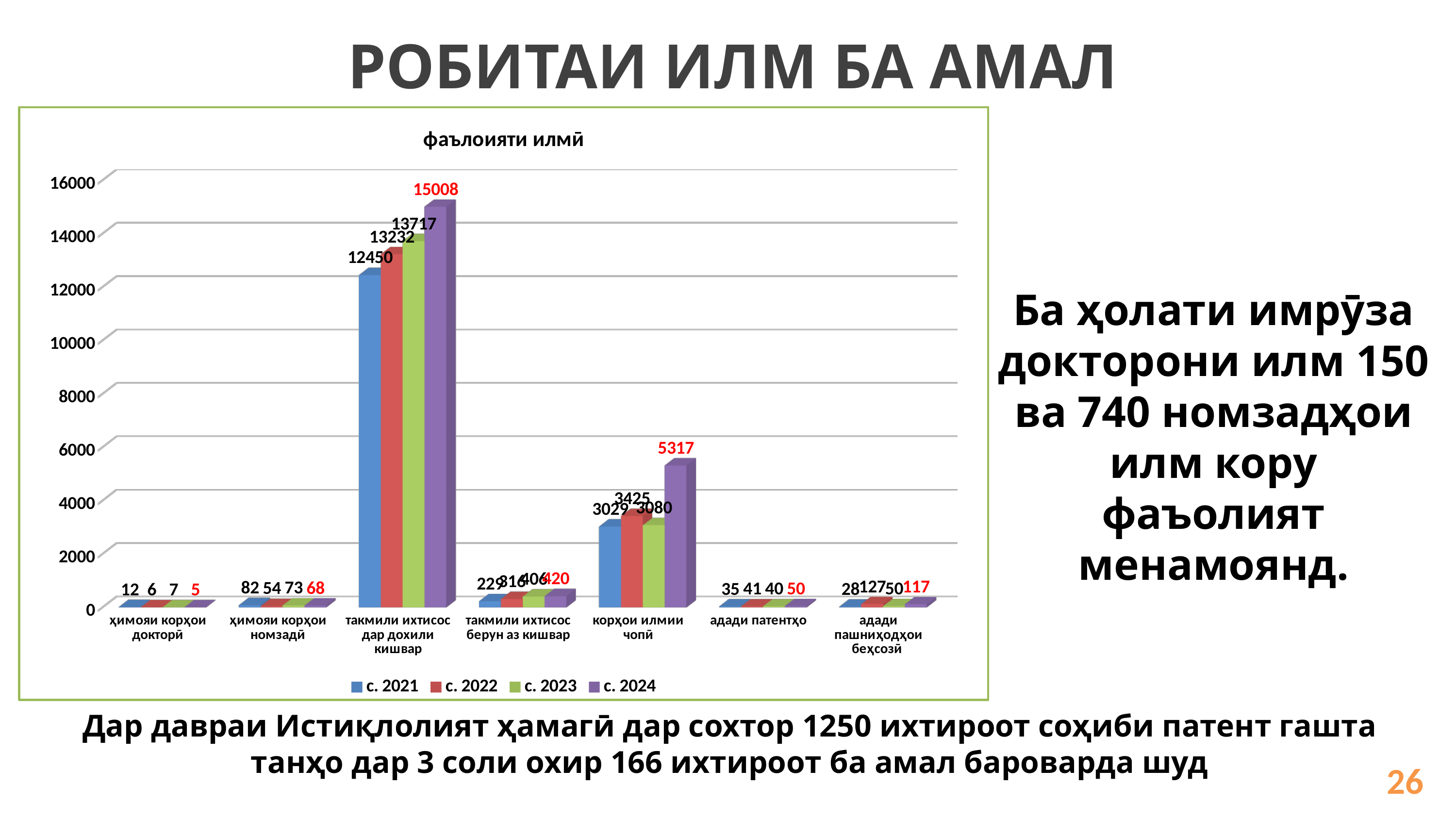
Which series has the highest value in the category корҳои илмии чопӣ? с. 2024 What is the value for с. 2024 in the category такмили ихтисос дар дохили кишвар? 15008 How many categories are shown on the x axis of the chart? 7 In the category такмили ихтисос дар дохили кишвар, how much larger is the с. 2024 value than the с. 2021 value? 2558 What kind of chart is shown on the slide? bar chart What is the value for с. 2022 in the category адади патентҳо? 41 What is the value for с. 2024 in the category ҳимояи корҳои номзадӣ? 68 How many series does the legend list? 4 Which series has the lowest value in the category ҳимояи корҳои докторӣ? с. 2024 In the category корҳои илмии чопӣ, which is larger: the value for с. 2022 or for с. 2023? с. 2022 Do the values for такмили ихтисос дар дохили кишвар rise or fall from с. 2021 to с. 2024? rise What is the value for с. 2021 in the category корҳои илмии чопӣ? 3029